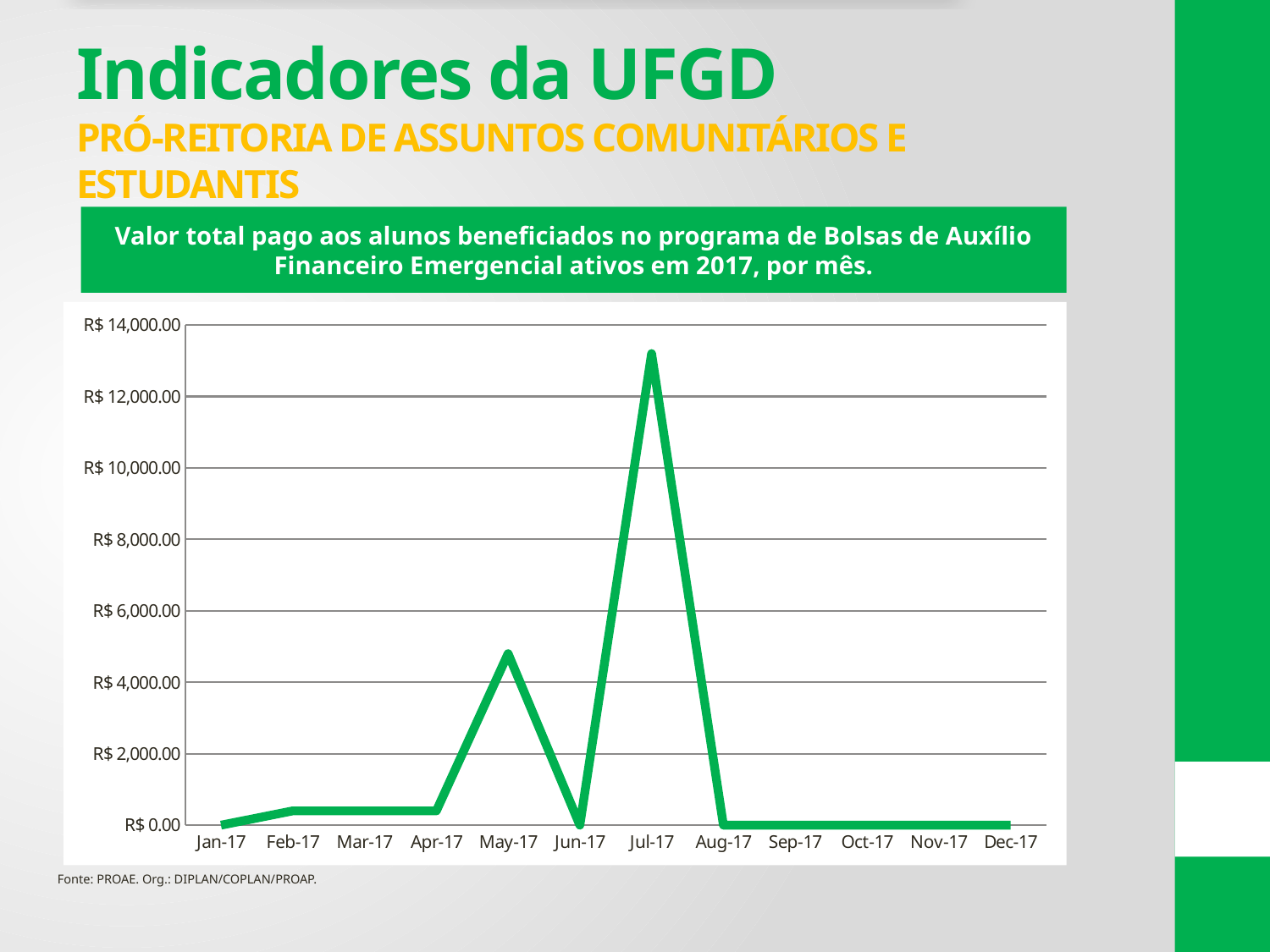
Is the value for May-17 greater or less than R$ 4,000.00? greater What kind of chart is shown on the slide? line chart Is the value for Jul-17 greater or less than R$ 12,000.00? greater Does the value rise or fall from Jun-17 to Jul-17? rise Is the value for Feb-17 greater or less than R$ 2,000.00? less How many months are plotted along the x axis of the chart? 12 Which month has the larger value, Apr-17 or May-17? May-17 Which month has the larger value, May-17 or Jul-17? Jul-17 Which month has the highest value in the chart? Jul-17 Does the value rise or fall from Jul-17 to Aug-17? fall What colour is the line in the chart? green